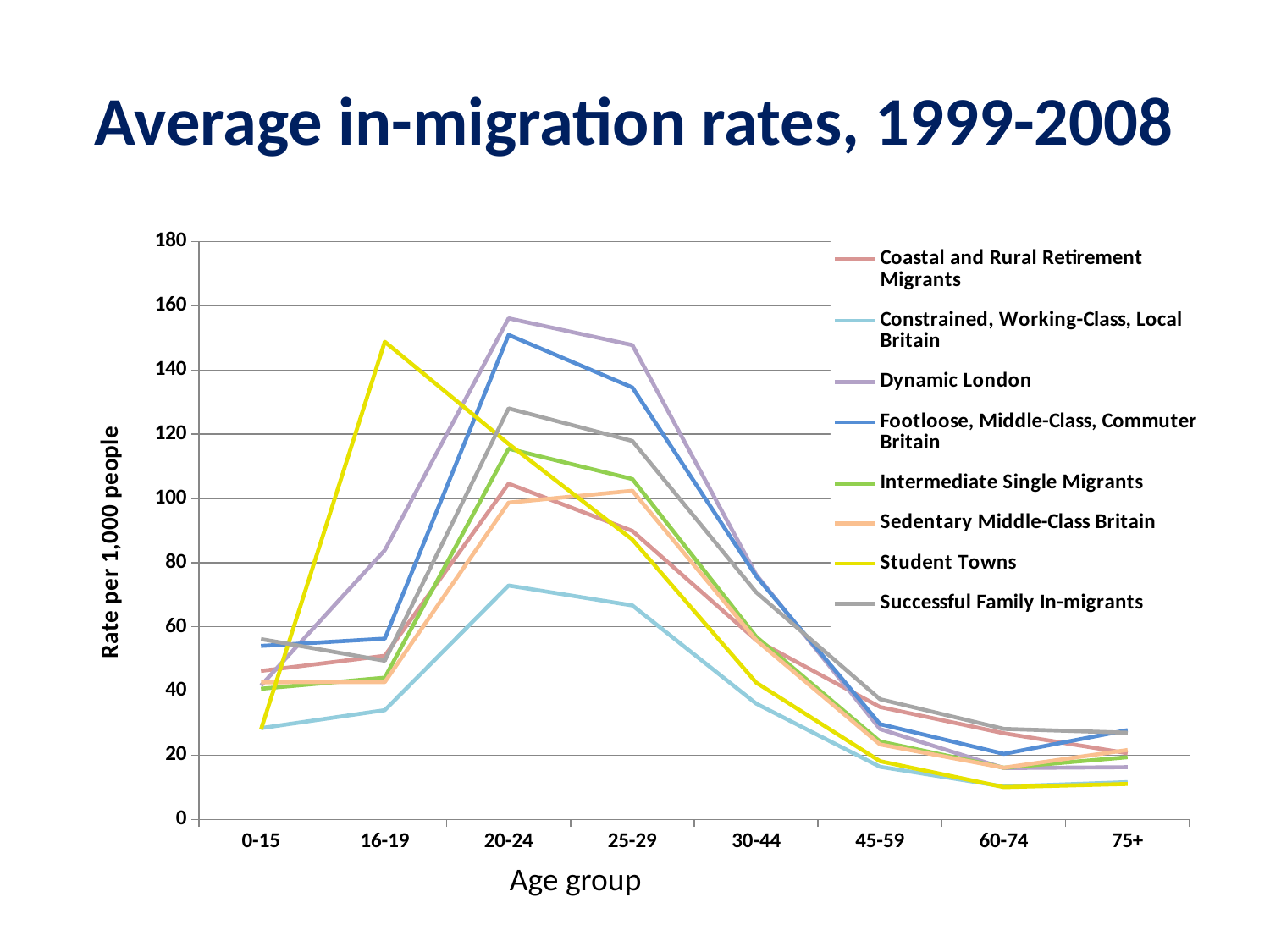
What kind of chart is shown on the slide? Line chart Which age group has the highest value for Student Towns? 16-19 Which age group has the highest value for Dynamic London? 20-24 Is the value for Student Towns at age group 16-19 greater or less than 140? greater Which series has the lowest value at age group 20-24? Constrained, Working-Class, Local Britain What is the label of the y axis? Rate per 1,000 people Do the values for Constrained, Working-Class, Local Britain rise or fall from age group 25-29 to 60-74? Fall Which series has the highest value at age group 16-19? Student Towns How many age groups are shown on the x axis? 8 At age group 25-29, which is larger: Dynamic London or Footloose, Middle-Class, Commuter Britain? Dynamic London How many series does the legend list? 8 Is the value for Constrained, Working-Class, Local Britain at age group 20-24 greater or less than 80? less